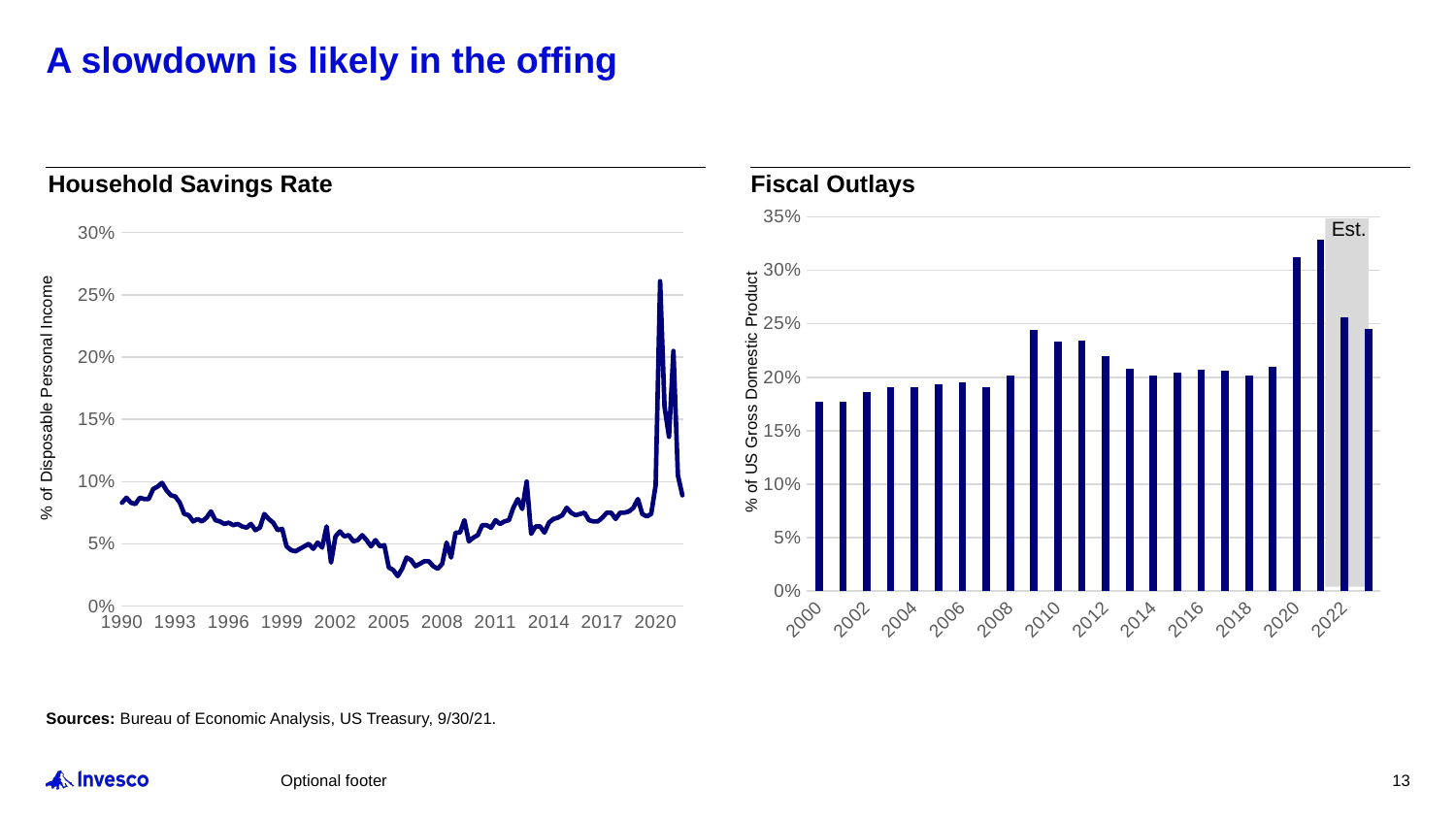
In the Household Savings Rate chart, does the savings rate generally rise or fall between 1993 and 2005? fall What is the y-axis label of the Fiscal Outlays chart? % of US Gross Domestic Product In the Fiscal Outlays chart, is the value for 2020 greater or less than 30%? greater In the Fiscal Outlays chart, which is larger, the value for 2020 or the value for 2010? 2020 What kind of chart is the Fiscal Outlays chart? bar chart In the Fiscal Outlays chart, is the value for 2000 greater or less than 20%? less In the Household Savings Rate chart, is the peak value around 2020 greater or less than 25%? greater In the Fiscal Outlays chart, which year has the highest bar? 2021 What kind of chart is the Household Savings Rate chart? line chart In the Fiscal Outlays chart, how many bars are plotted? 24